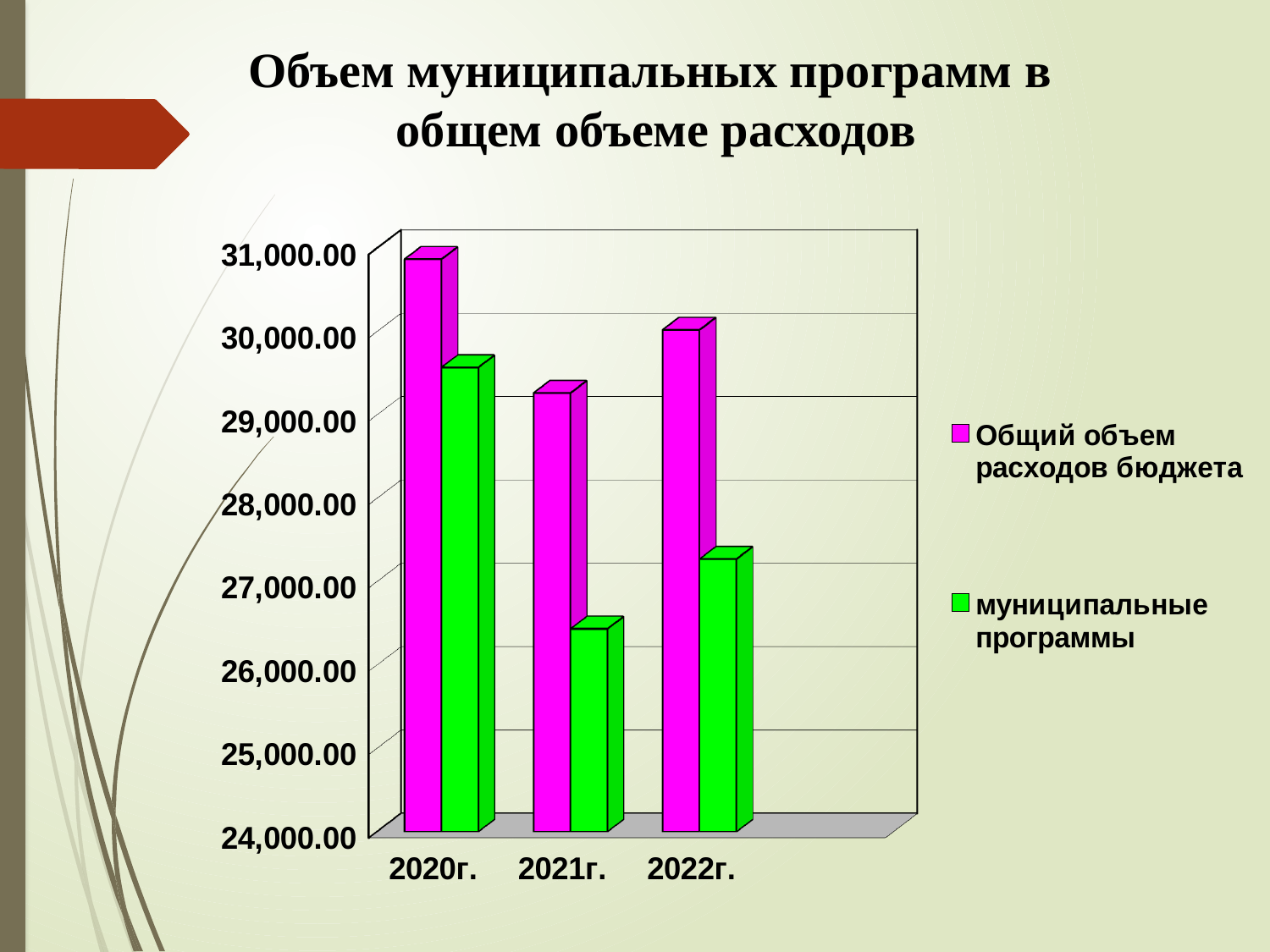
Which is larger: Общий объем расходов бюджета in 2022г. or in 2021г.? 2022г. Which year has the highest value for Общий объем расходов бюджета? 2020г. Does the value for Общий объем расходов бюджета rise or fall from 2020г. to 2021г.? fall Is the value for Общий объем расходов бюджета in 2020г. greater or less than 30,000.00? greater Is the value for Общий объем расходов бюджета in 2021г. greater or less than 30,000.00? less What colour are the bars for муниципальные программы? green How many years (categories) are shown on the x axis? 3 Is the value for муниципальные программы in 2021г. greater or less than 27,000.00? less How many series does the legend list? 2 What kind of chart is shown on the slide? bar chart Which year has the lowest value for муниципальные программы? 2021г.